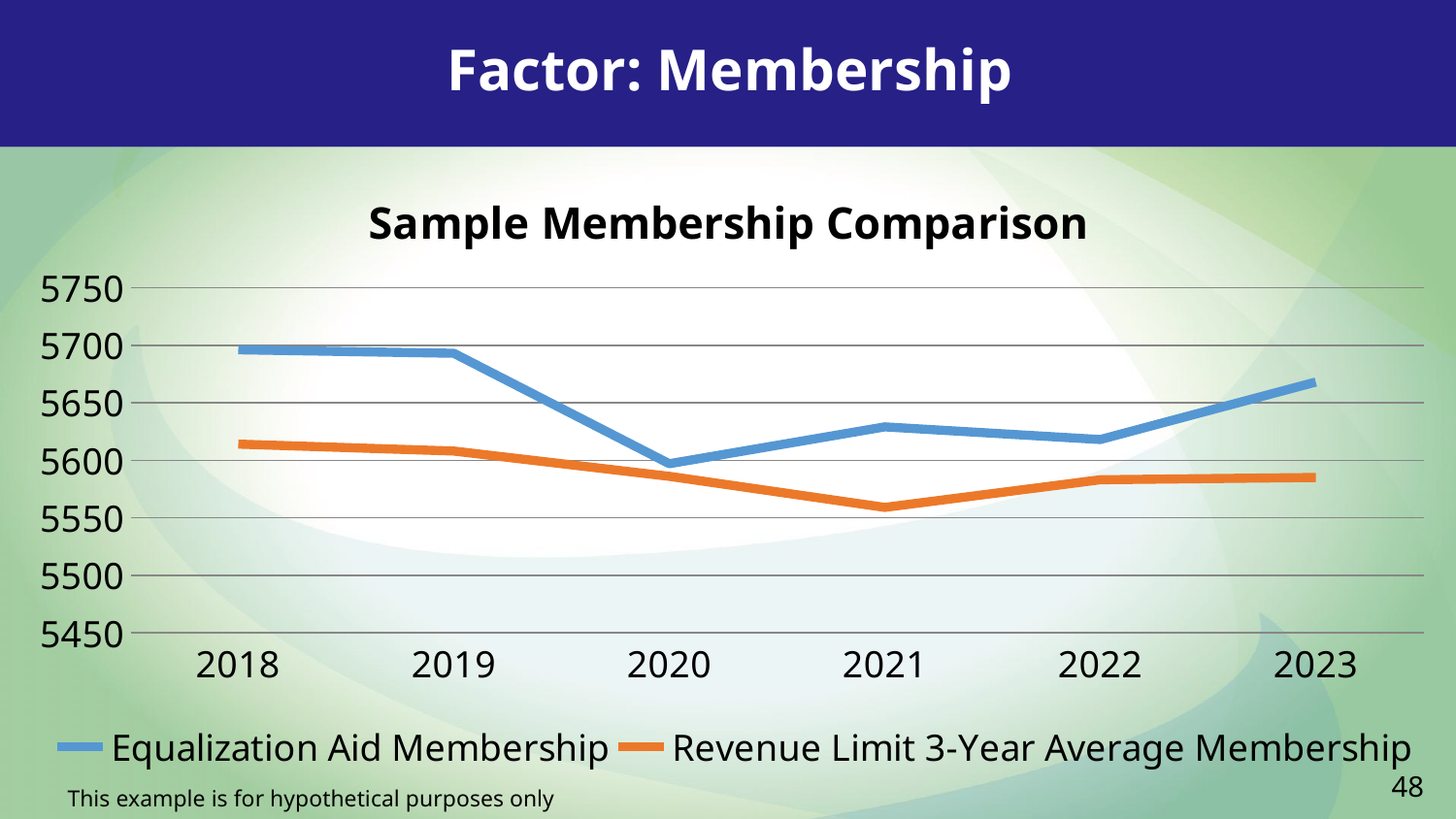
Is the Revenue Limit 3-Year Average Membership value for 2021 greater or less than 5600? less Is the Equalization Aid Membership value for 2018 greater or less than 5650? greater In which year is Revenue Limit 3-Year Average Membership lowest? 2021 How many years are shown on the x axis? 6 Is the Equalization Aid Membership value for 2023 greater or less than 5650? greater What kind of chart is shown on the slide? Line chart In 2018, which is larger: Equalization Aid Membership or Revenue Limit 3-Year Average Membership? Equalization Aid Membership In which year is Equalization Aid Membership lowest? 2020 Which colour is the Revenue Limit 3-Year Average Membership line? Orange How many series does the legend list? 2 Does Revenue Limit 3-Year Average Membership rise or fall from 2018 to 2021? Fall What is the title of the chart? Sample Membership Comparison